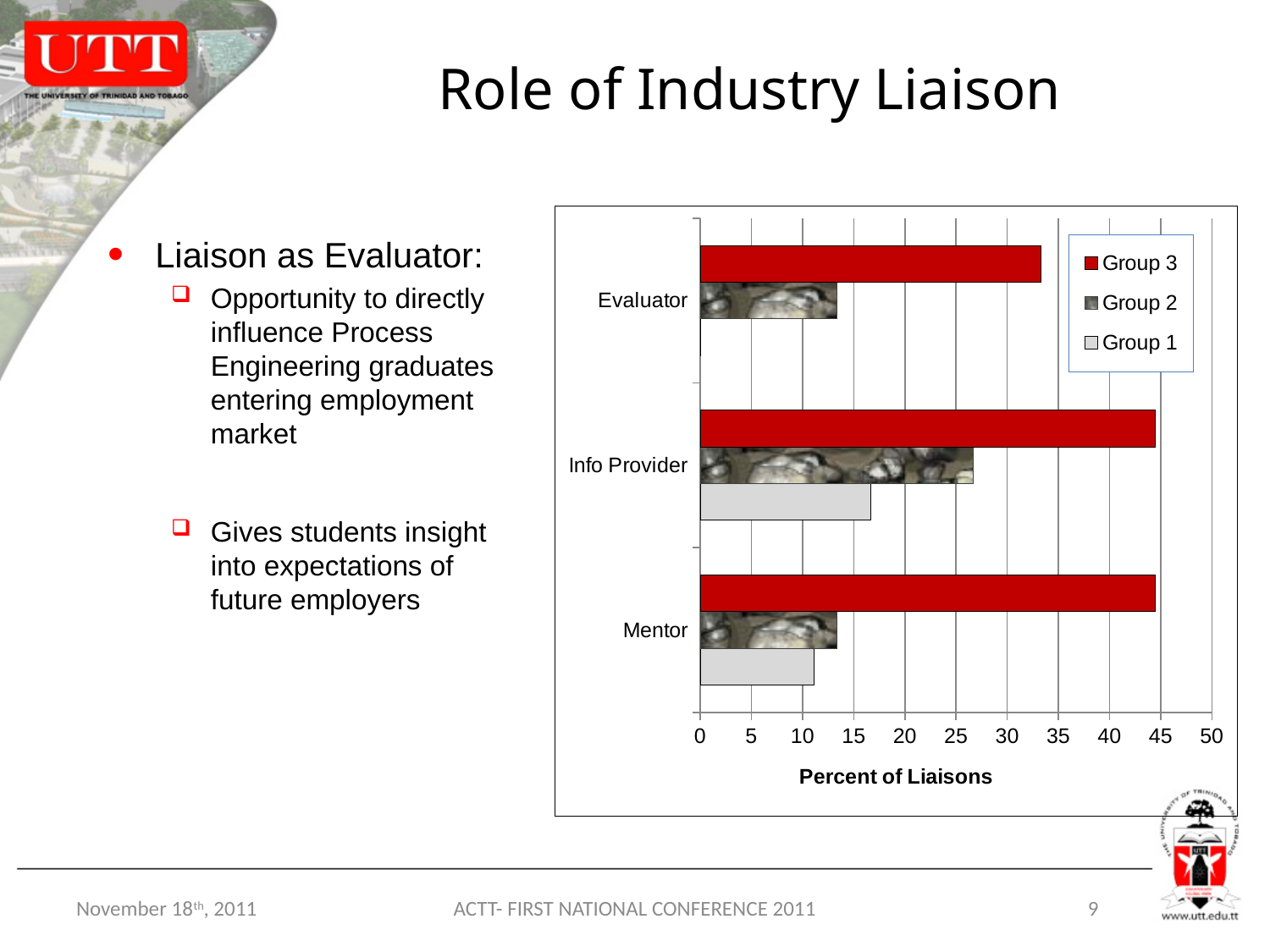
Is the Group 3 value for Info Provider greater or less than 40? greater For Group 2, which category has the highest value? Info Provider What is the title of the chart's horizontal axis? Percent of Liaisons How many categories are shown on the chart's vertical axis? 3 Is the Group 3 value for Evaluator greater or less than 30? greater Is the Group 2 value for Info Provider greater or less than 20? greater How many series does the chart's legend list? 3 For Mentor, which is larger: the Group 3 value or the Group 1 value? Group 3 Which series is shown in red on the chart? Group 3 What kind of chart is shown on the slide? bar chart For Group 3, which is larger: the value for Evaluator or the value for Info Provider? Info Provider